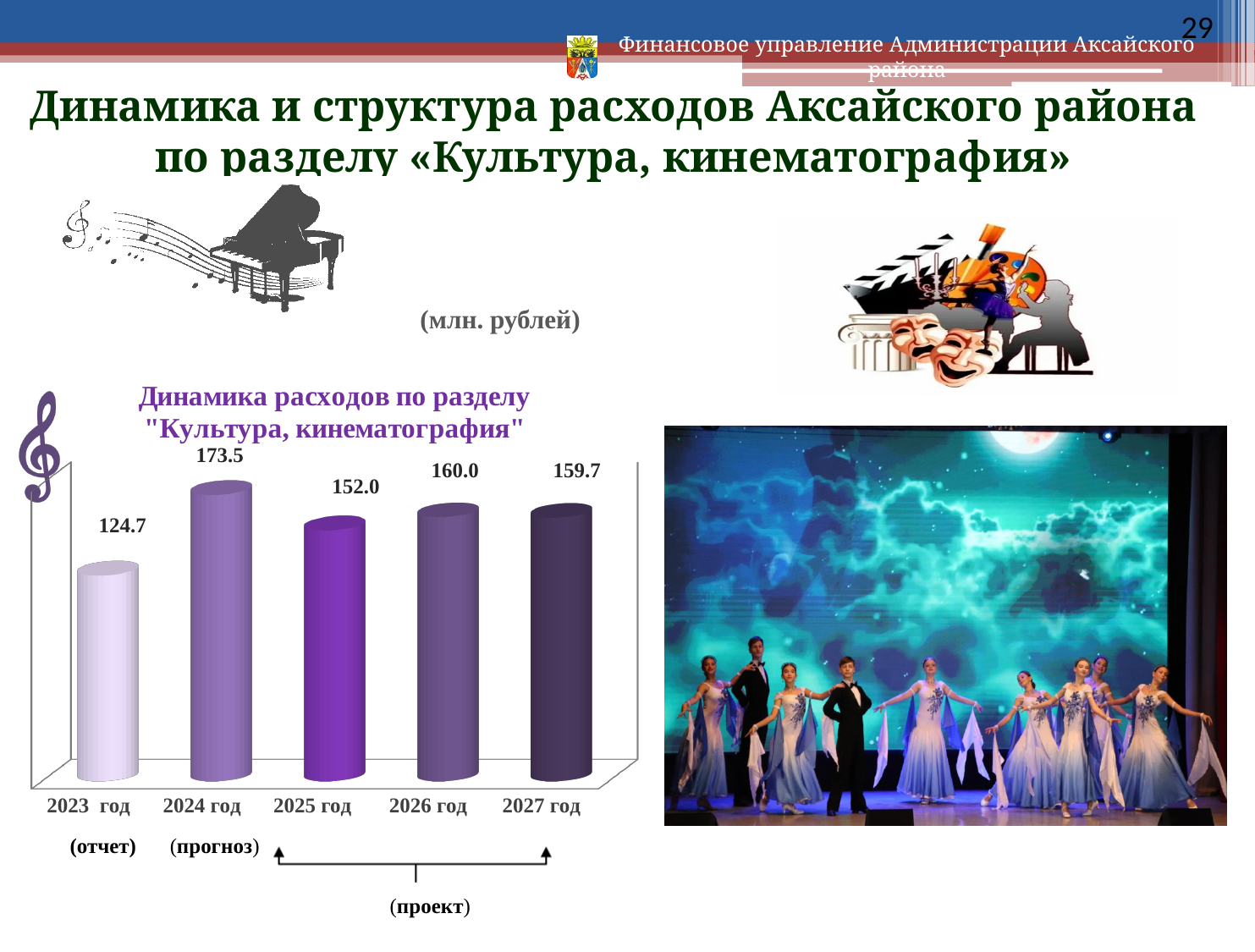
Which year has the lowest value? 2023 год What is the value for 2027 год? 159.7 What is the difference between the values for 2026 год and 2025 год? 8.0 Which year has the highest value? 2024 год What is the value for 2024 год? 173.5 What is the value for 2026 год? 160.0 What kind of chart is shown on the slide? Bar chart What is the difference between the values for 2024 год and 2023 год? 48.8 What unit of measurement is indicated for the chart values? млн. рублей What is the value for 2023 год? 124.7 Which is larger, the value for 2025 год or the value for 2024 год? 2024 год How many years are shown in the chart? 5